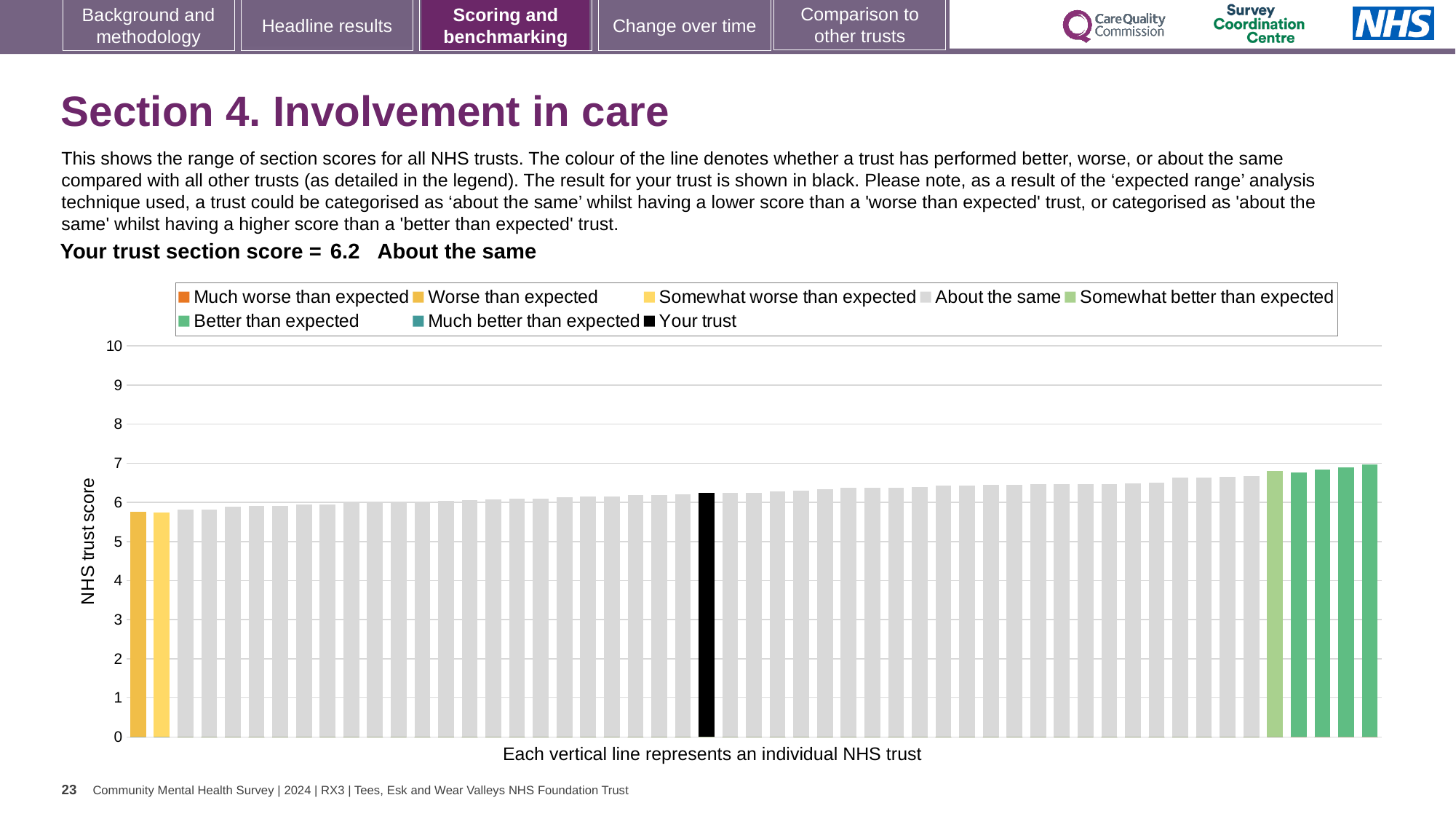
What is the label on the vertical axis of the chart? NHS trust score How is your trust's section score categorised compared with other trusts? About the same Is the value of the leftmost bar greater or less than 5? greater How many green bars (somewhat better or better than expected) are shown at the right of the chart? 5 Is the value for your trust (the black bar) greater or less than 5? greater What kind of chart is shown on the slide? bar chart Is the value of the rightmost bar greater or less than 6? greater Do the bar values rise or fall from left to right along the x axis? rise What is the section score for your trust shown on the slide? 6.2 How many entries does the chart legend list? 8 What colour is the bar representing your trust? black Which is larger: the black bar for your trust or the leftmost bar? the black bar for your trust